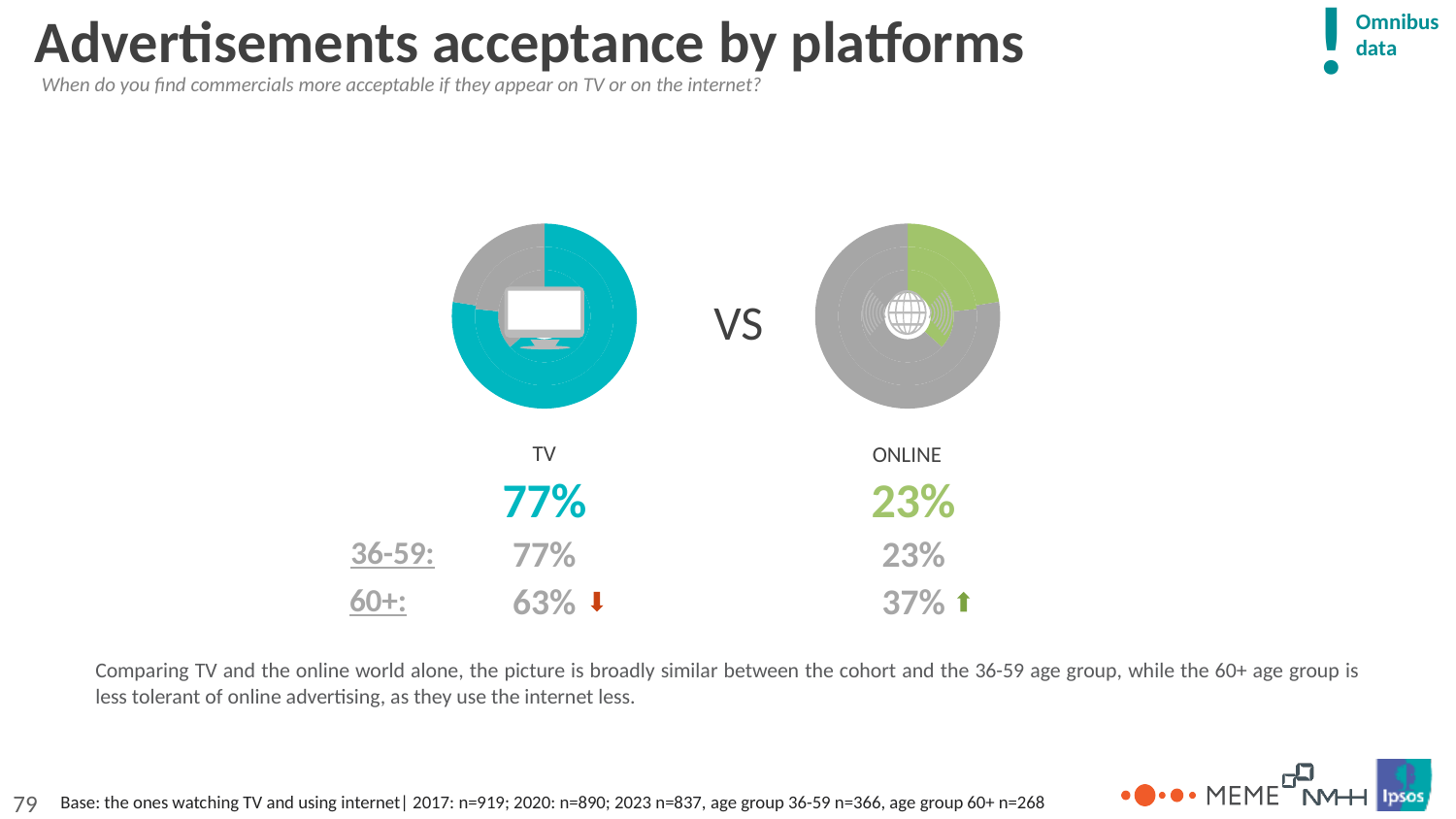
How many platforms are compared on the slide? 2 What is the title of the slide containing the charts? Advertisements acceptance by platforms What percentage is shown for ONLINE in the right chart? 23% What is the difference between the TV share and the ONLINE share? 54% What is the ONLINE share for the 60+ age group? 37% Which platform has the higher share, TV or ONLINE? TV What percentage is shown for TV in the left chart? 77% What is the TV share for the 60+ age group? 63% What is the difference between the ONLINE share for the 60+ age group and the ONLINE share for the 36-59 age group? 14% Which platform has the lowest share on the slide? ONLINE What kind of chart is used to show the TV and ONLINE shares on this slide? doughnut chart What is the TV share for the 36-59 age group? 77%